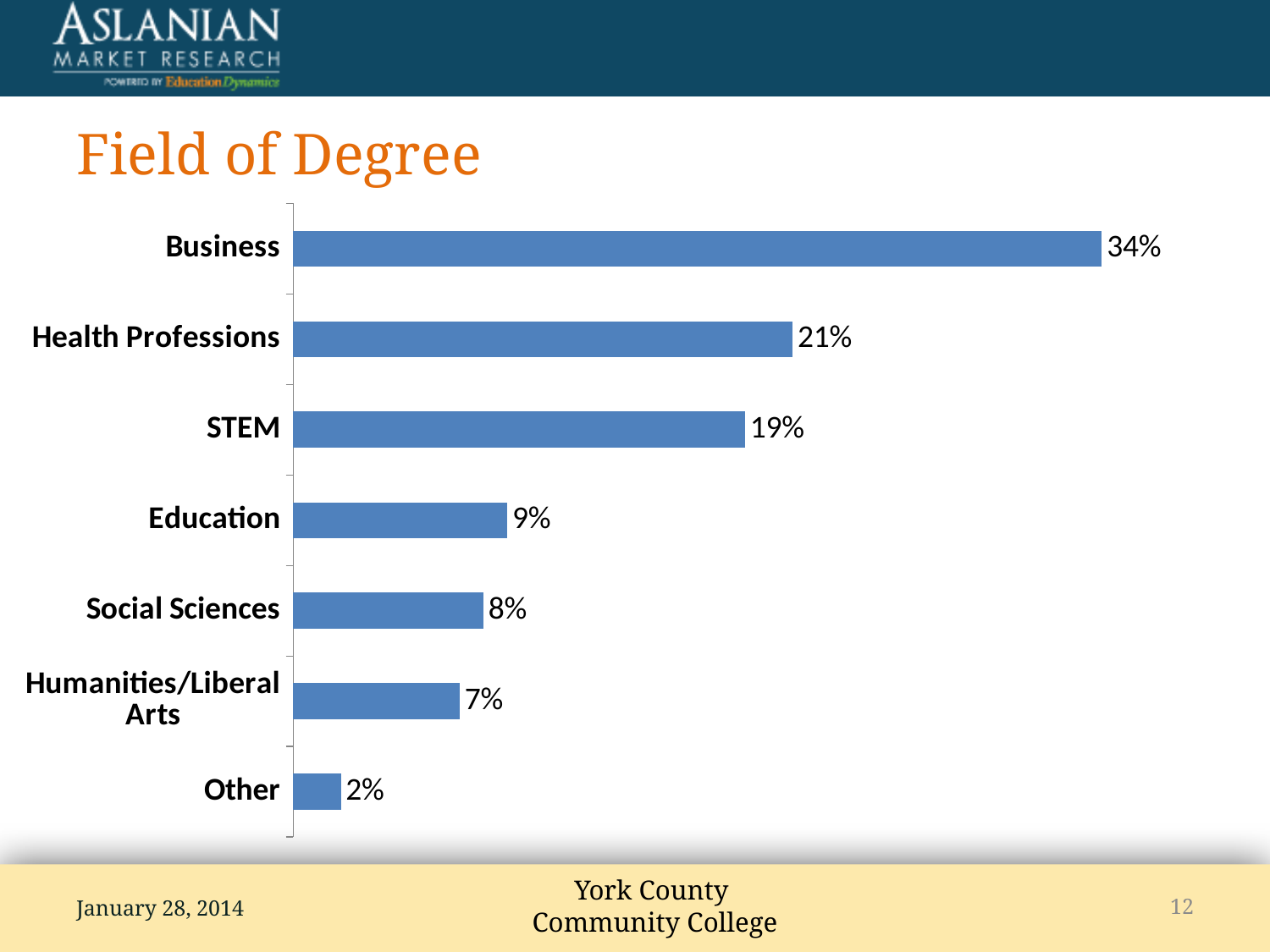
Which field of degree has the highest percentage? Business What is the title of the chart on the slide? Field of Degree What percentage is shown for Business? 34% What percentage is shown for STEM? 19% Which is larger, the value for STEM or the value for Education? STEM What kind of chart is shown on the slide? Bar chart How many fields of degree are shown in the chart? 7 What is the value for Health Professions? 21% What is the difference between the values for Education and Social Sciences? 1% Which field of degree has the lowest percentage? Other What is the difference between the values for Business and Health Professions? 13% What is the value for Humanities/Liberal Arts? 7%